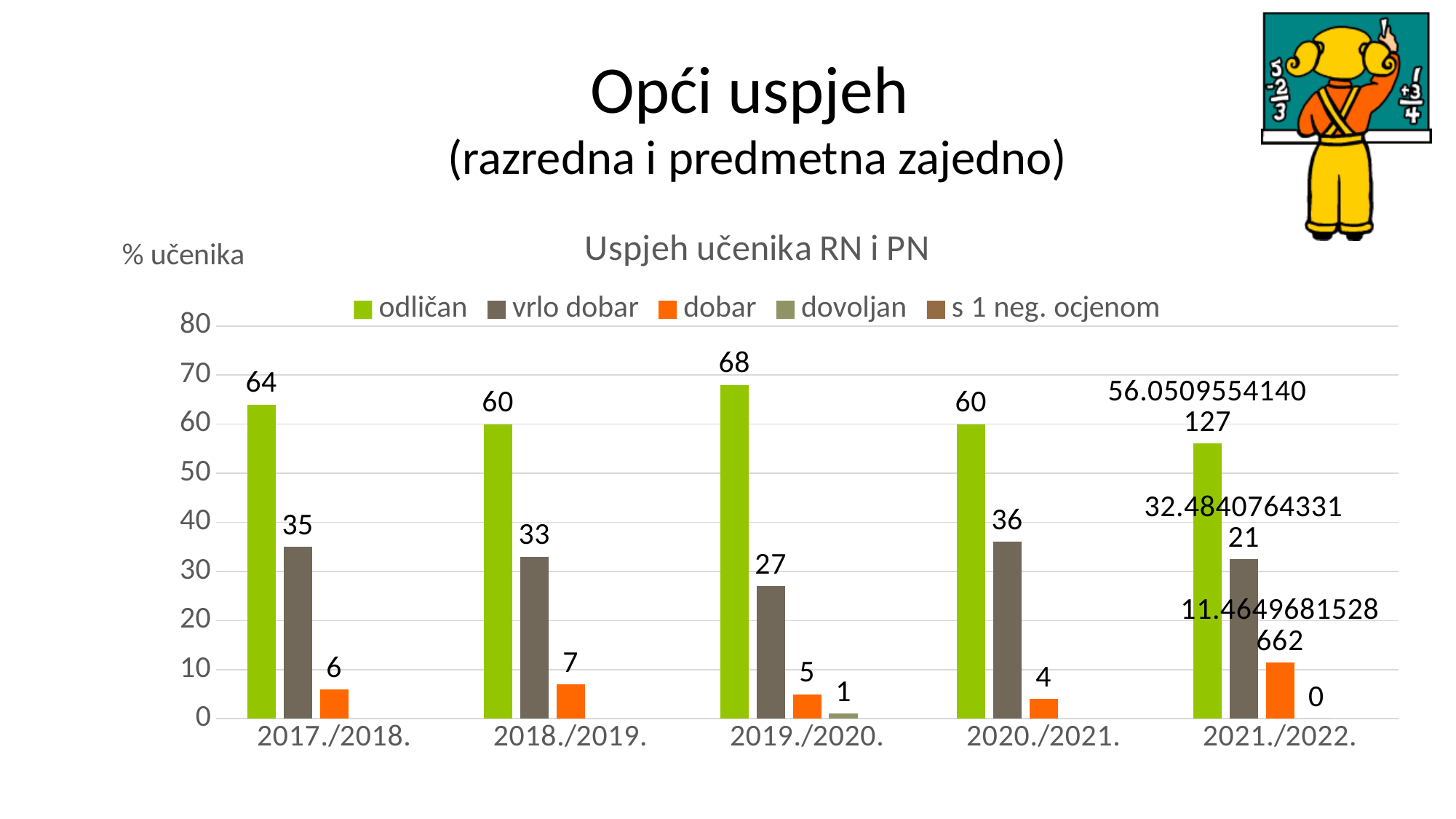
How many school years are shown on the x axis? 5 Which is larger, vrlo dobar in 2017./2018. or vrlo dobar in 2018./2019.? vrlo dobar in 2017./2018. What is the difference between odličan and vrlo dobar in 2017./2018.? 29 What is the value for odličan in 2019./2020.? 68 How many series does the legend list? 5 In which school year is the value for odličan highest? 2019./2020. In which school year is the value for dobar lowest among the years with a printed whole-number label (2017./2018. to 2020./2021.)? 2020./2021. Is the value for odličan in 2021./2022. greater or less than 60? less What is the value for dovoljan in 2019./2020.? 1 What kind of chart is shown on the slide? bar chart What is the value for dobar in 2018./2019.? 7 What is the value for vrlo dobar in 2020./2021.? 36